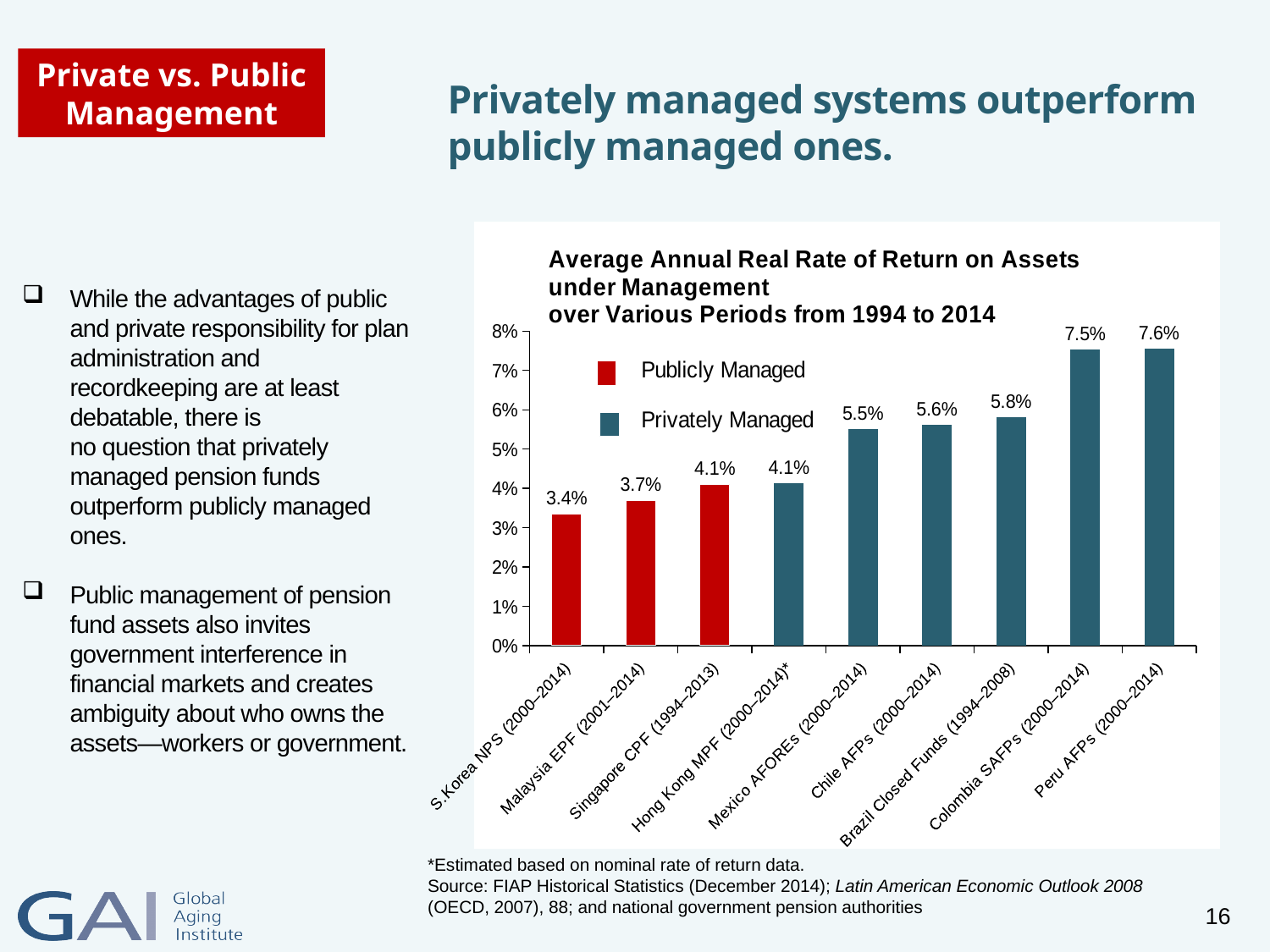
How many series does the legend list? 2 What is the value shown for Peru AFPs (2000–2014)? 7.6% What is the difference between the rate of return for Colombia SAFPs (2000–2014) and Malaysia EPF (2001–2014)? 3.8% How many pension systems are plotted on the chart? 9 Which colour represents the Publicly Managed series in the chart? Red What type of chart is shown on the slide? Bar chart Which has a higher rate of return, Brazil Closed Funds (1994–2008) or Singapore CPF (1994–2013)? Brazil Closed Funds (1994–2008) What is the average annual real rate of return for Chile AFPs (2000–2014)? 5.6% Is the value for Mexico AFOREs (2000–2014) greater or less than 5%? greater Which category has the lowest rate of return on the chart? S. Korea NPS (2000–2014) What is the average annual real rate of return for S. Korea NPS (2000–2014)? 3.4% Which category has the highest rate of return on the chart? Peru AFPs (2000–2014)